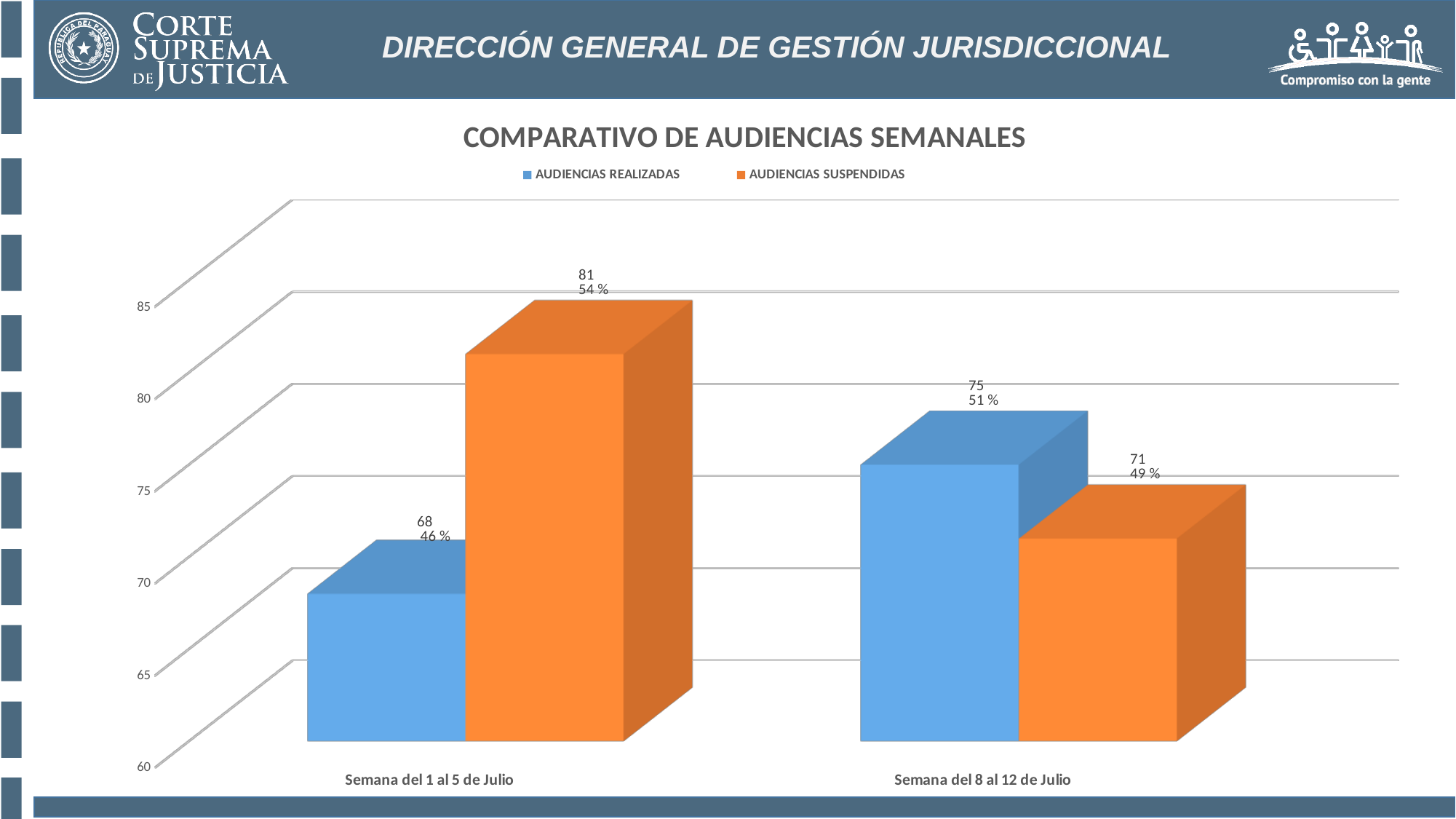
How many series does the legend list? 2 What is the title of the chart? COMPARATIVO DE AUDIENCIAS SEMANALES What is the value for AUDIENCIAS REALIZADAS in the week 'Semana del 8 al 12 de Julio'? 75 What is the value for AUDIENCIAS SUSPENDIDAS in the week 'Semana del 1 al 5 de Julio'? 81 What is the value for AUDIENCIAS SUSPENDIDAS in the week 'Semana del 8 al 12 de Julio'? 71 What percentage is shown for AUDIENCIAS SUSPENDIDAS in the week 'Semana del 1 al 5 de Julio'? 54 % In the week 'Semana del 8 al 12 de Julio', which is larger: AUDIENCIAS REALIZADAS or AUDIENCIAS SUSPENDIDAS? AUDIENCIAS REALIZADAS Which week has the lowest value for AUDIENCIAS REALIZADAS? Semana del 1 al 5 de Julio What is the value for AUDIENCIAS REALIZADAS in the week 'Semana del 1 al 5 de Julio'? 68 Which week has the highest value for AUDIENCIAS SUSPENDIDAS? Semana del 1 al 5 de Julio What is the difference between AUDIENCIAS SUSPENDIDAS and AUDIENCIAS REALIZADAS in the week 'Semana del 1 al 5 de Julio'? 13 What kind of chart is shown on the slide? Bar chart